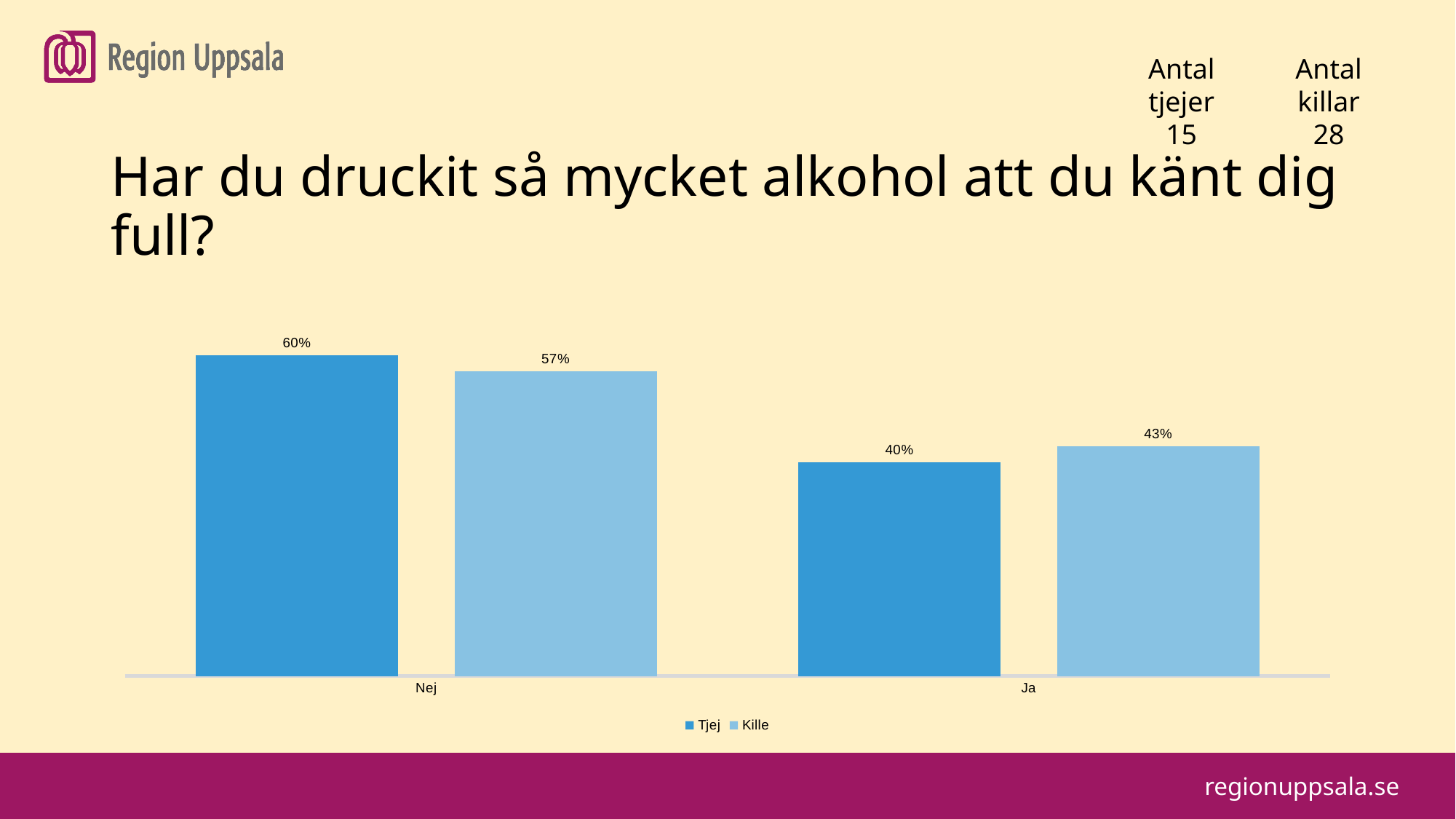
What kind of chart is shown on the slide? Bar chart What is the value for Tjej in the Nej category? 60% How many series does the legend list? 2 What is the difference between the Tjej and Kille values in the Nej category? 3% What is the difference between the Kille values for Nej and Ja? 14% What is the value for Tjej in the Ja category? 40% Which is larger: the Tjej value for Nej or the Tjej value for Ja? Nej Which series has the lowest value in the Ja category? Tjej What is the value for Kille in the Nej category? 57% What is the value for Kille in the Ja category? 43% Which series has the highest value in the Nej category? Tjej How many categories are shown on the x axis? 2